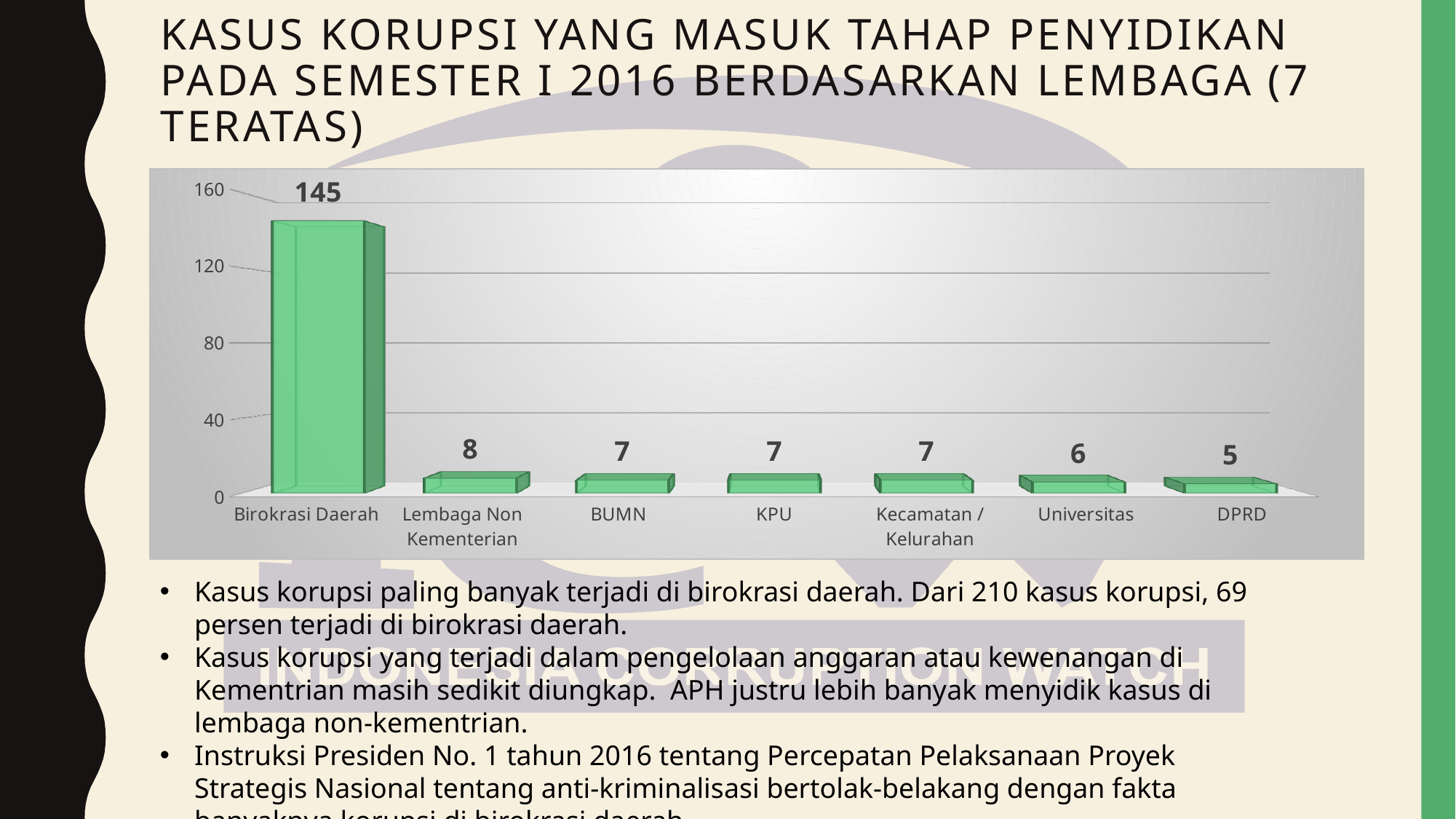
What is the difference between the values for Birokrasi Daerah and Lembaga Non Kementerian? 137 What is the value for Lembaga Non Kementerian? 8 Which category has the highest value? Birokrasi Daerah What kind of chart is shown on the slide? bar chart Which category has the lowest value? DPRD What is the value for Universitas? 6 Is the value for Birokrasi Daerah greater or less than 120? greater What is the value for Birokrasi Daerah? 145 Which is larger, the value for Lembaga Non Kementerian or the value for Universitas? Lembaga Non Kementerian How many categories are shown on the x axis? 7 What is the difference between the values for BUMN and DPRD? 2 What is the value for DPRD? 5